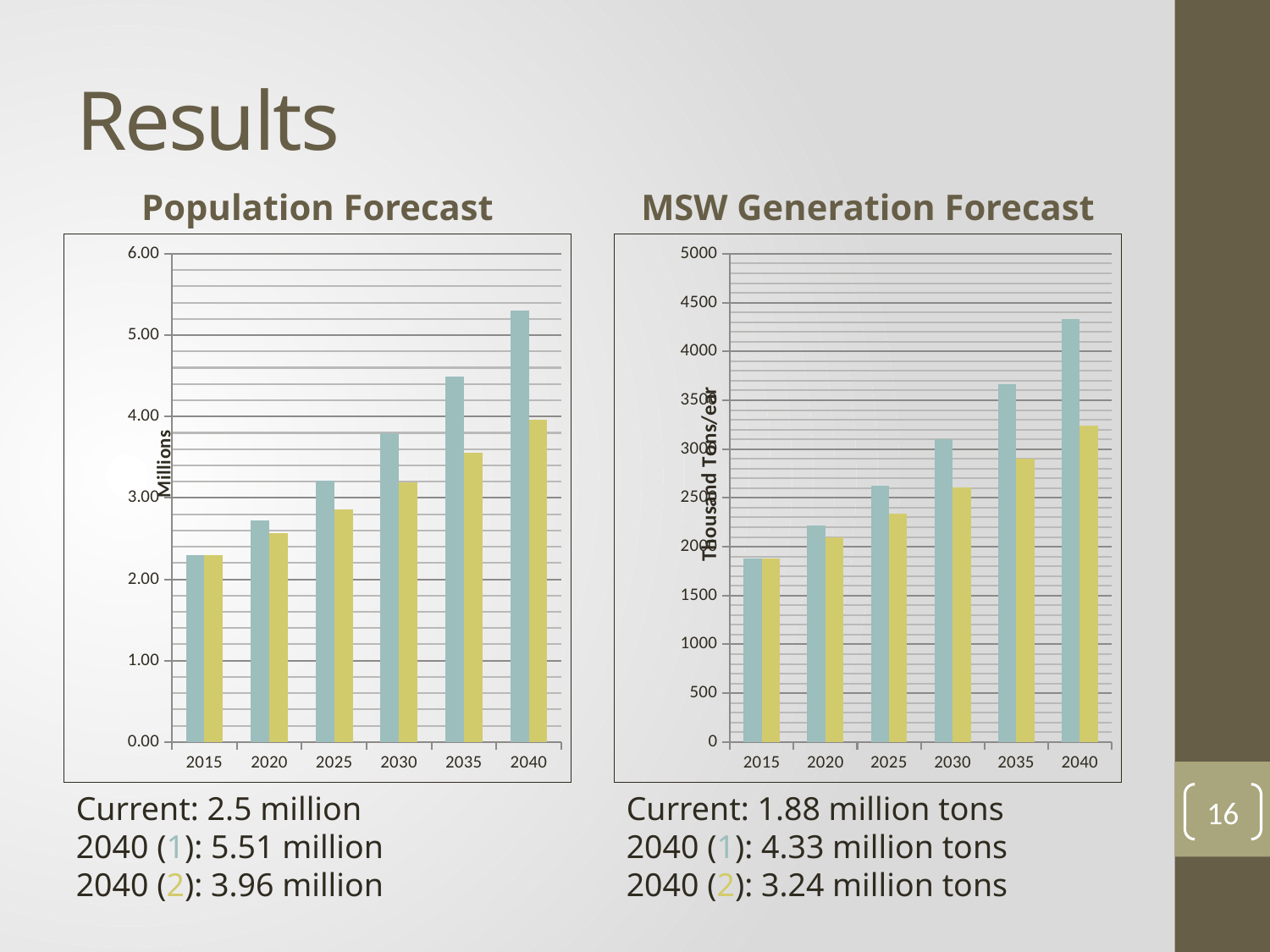
In the MSW Generation Forecast chart, which year has the lowest bars? 2015 In the Population Forecast chart, which year has the tallest bar? 2040 In the MSW Generation Forecast chart, are the bars for 2015 greater or less than 2000? less In the MSW Generation Forecast chart, is the taller (blue) bar for 2040 greater or less than 4000? greater How many years are shown on the x axis of the MSW Generation Forecast chart? 6 In the MSW Generation Forecast chart, which 2040 bar is larger, the blue one or the yellow one? the blue one In the Population Forecast chart, is the taller (blue) bar for 2040 greater or less than 5.00? greater What kind of chart is the Population Forecast chart? bar chart In the Population Forecast chart, do the values rise or fall from 2015 to 2040? rise What is the y-axis title of the Population Forecast chart? Millions What is the title of the chart on the right side of the slide? MSW Generation Forecast